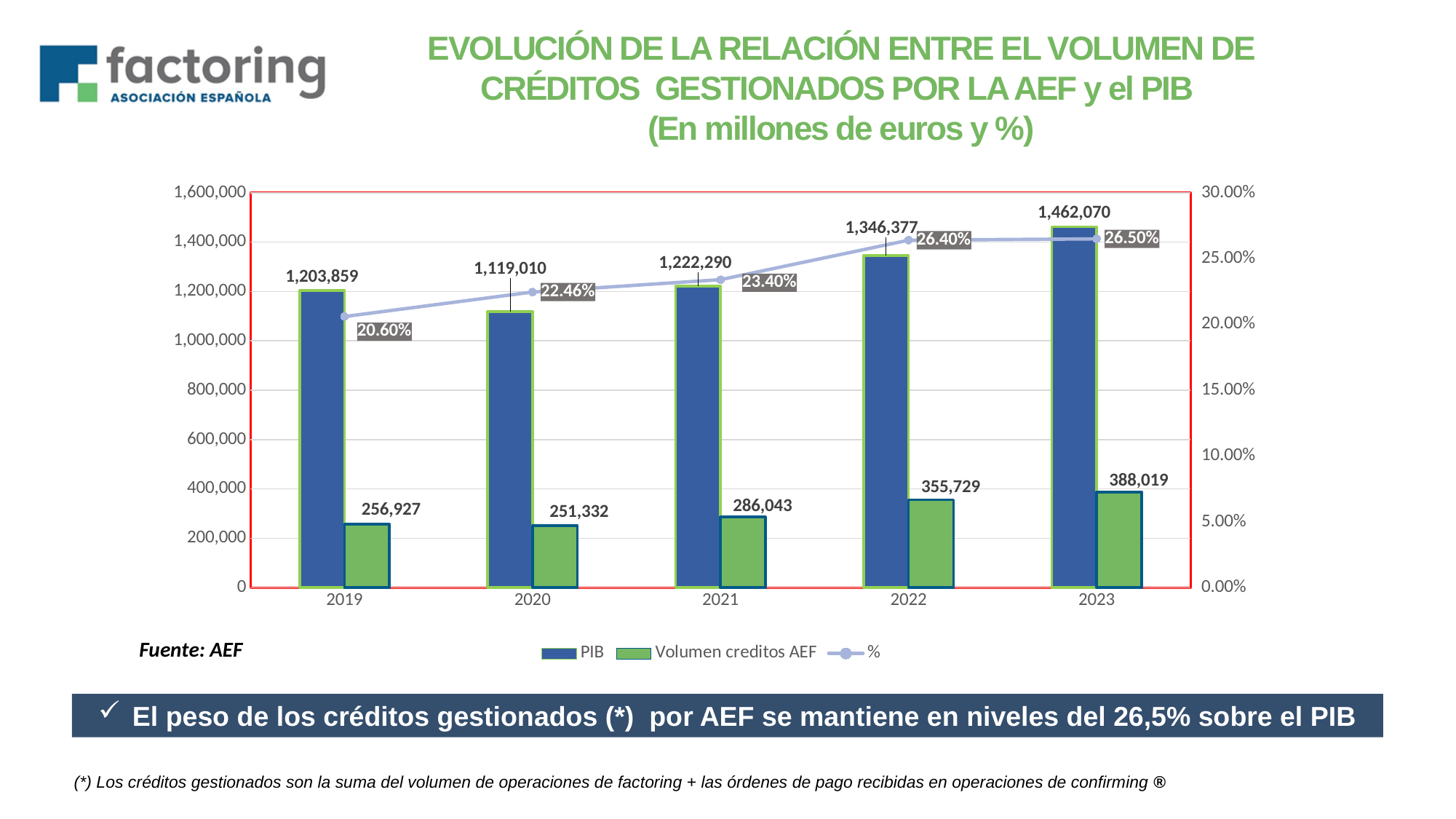
How many series does the legend list? 3 What is the Volumen creditos AEF value for 2022? 355,729 What is the difference between the PIB values for 2023 and 2022? 115,693 Which year has the lowest Volumen creditos AEF value? 2020 What is the PIB value for 2021? 1,222,290 What kind of chart is shown on the slide? Combined bar and line chart Which is larger, the PIB value for 2019 or the PIB value for 2020? 2019 Does the % line rise or fall from 2019 to 2023? Rises How many years are shown on the x axis? 5 By how much did the Volumen creditos AEF increase from 2019 to 2023? 131,092 Which year has the highest PIB value? 2023 What percentage (%) is shown for 2020? 22.46%